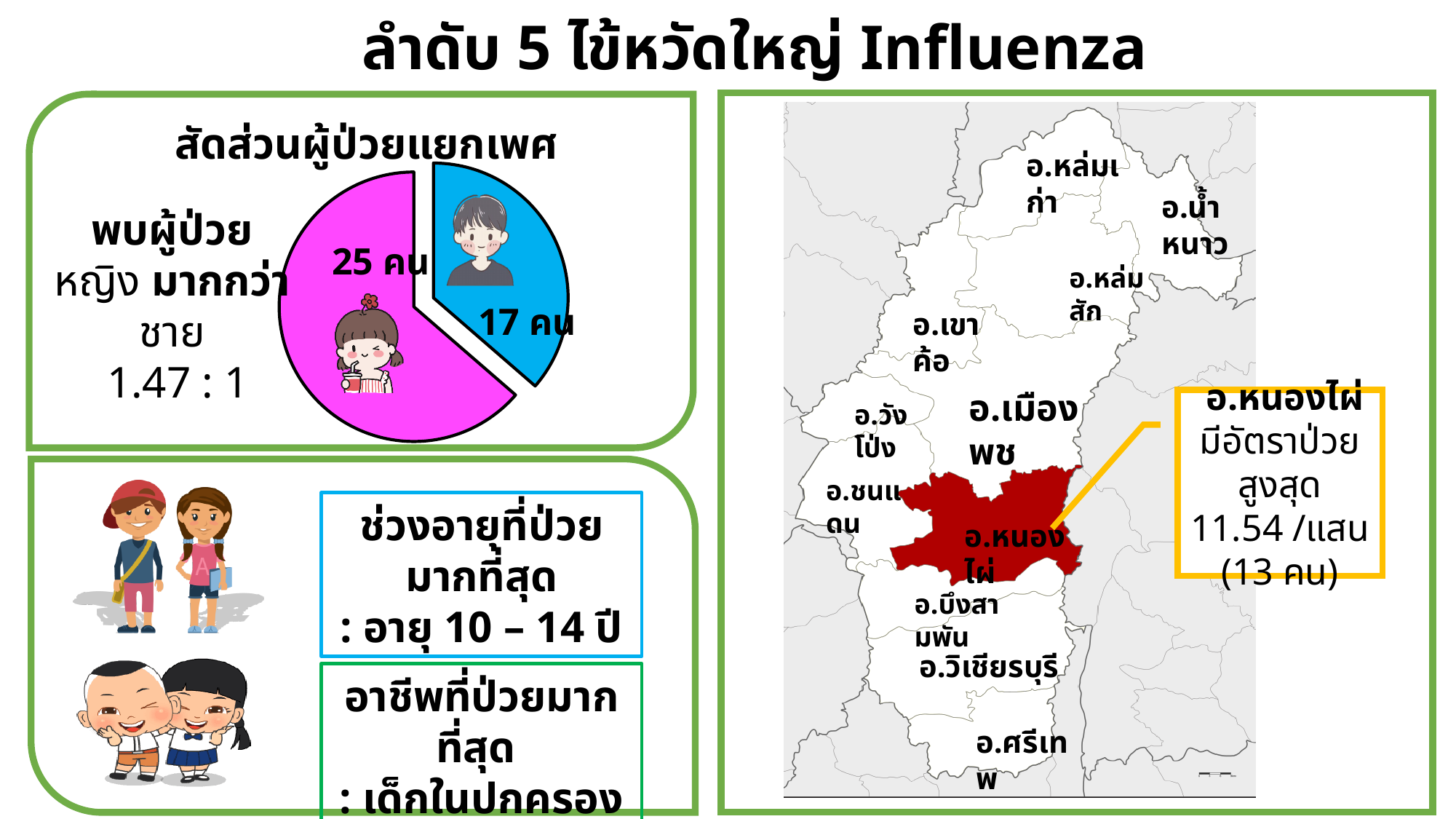
In the pie chart สัดส่วนผู้ป่วยแยกเพศ, how many patients are male (ชาย)? 17 คน In the pie chart สัดส่วนผู้ป่วยแยกเพศ, what is the difference between the number of female and male patients? 8 คน How many slices does the pie chart สัดส่วนผู้ป่วยแยกเพศ have? 2 In the pie chart สัดส่วนผู้ป่วยแยกเพศ, is the number of female patients greater or less than 20? greater In the pie chart สัดส่วนผู้ป่วยแยกเพศ, what colour is the slice for male patients (17 คน)? blue What female-to-male ratio is stated next to the pie chart สัดส่วนผู้ป่วยแยกเพศ? 1.47 : 1 What kind of chart is shown under the title สัดส่วนผู้ป่วยแยกเพศ? pie chart In the pie chart สัดส่วนผู้ป่วยแยกเพศ, how many patients are female (หญิง)? 25 คน In the pie chart สัดส่วนผู้ป่วยแยกเพศ, which group has the smallest slice? male (ชาย) In the pie chart สัดส่วนผู้ป่วยแยกเพศ, which group has the larger slice, female or male? female (หญิง) In the pie chart สัดส่วนผู้ป่วยแยกเพศ, what colour is the slice for female patients (25 คน)? magenta/pink In the pie chart สัดส่วนผู้ป่วยแยกเพศ, what is the total number of patients across both slices? 42 คน